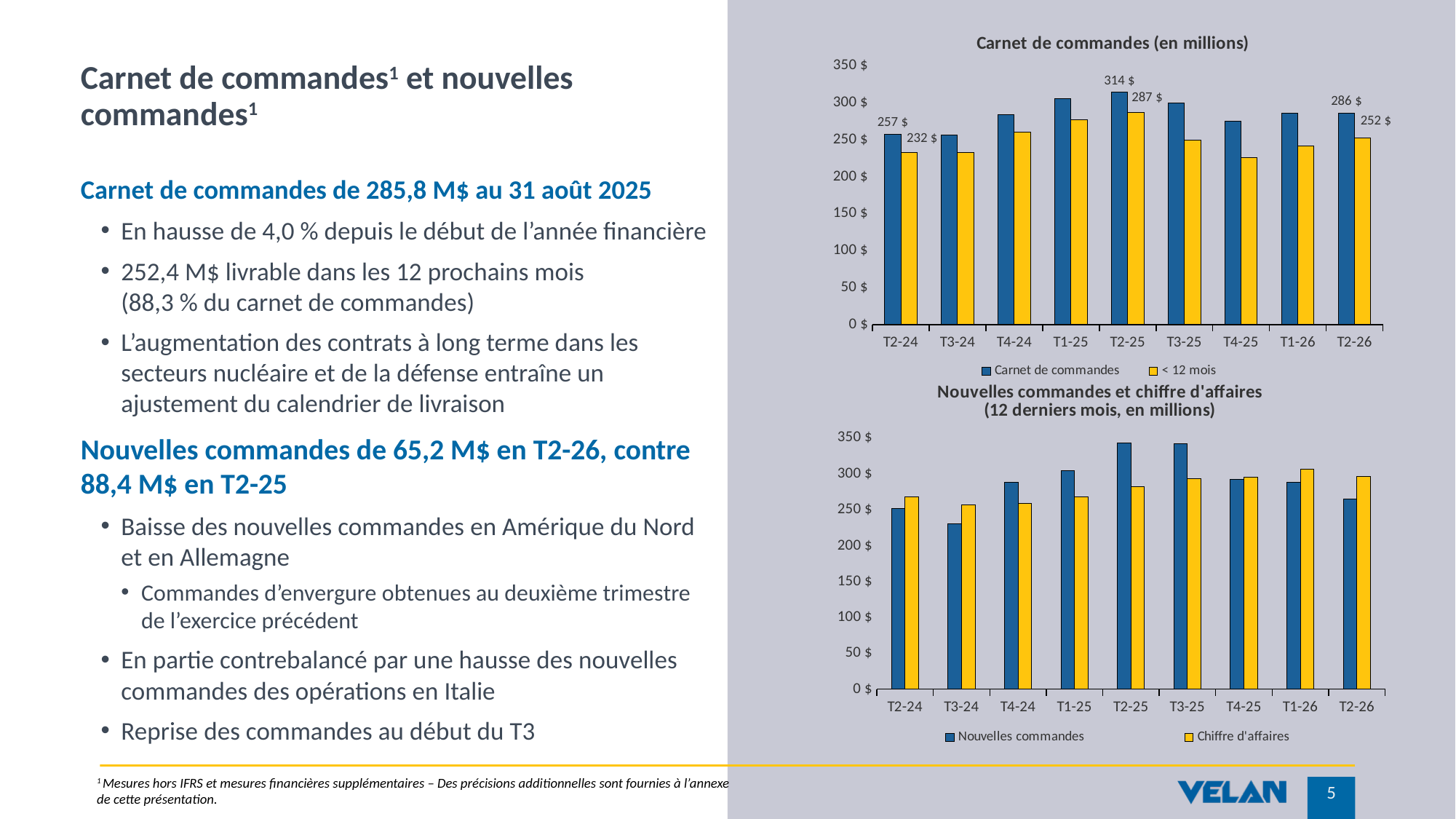
In the chart titled "Carnet de commandes (en millions)", what is the difference between the Carnet de commandes value and the "< 12 mois" value for T2-25? 27 $ In the chart titled "Carnet de commandes (en millions)", by how much did the Carnet de commandes value change from T2-24 to T2-26? 29 $ In the chart titled "Nouvelles commandes et chiffre d'affaires", is the Nouvelles commandes value for T2-25 greater or less than 300 $? greater In the chart titled "Nouvelles commandes et chiffre d'affaires", which is larger for T2-26: Nouvelles commandes or Chiffre d'affaires? Chiffre d'affaires In the chart titled "Carnet de commandes (en millions)", what is the value of the "< 12 mois" series for T2-26? 252 $ How many series does the legend list in the chart titled "Nouvelles commandes et chiffre d'affaires"? 2 What kind of chart is the chart titled "Nouvelles commandes et chiffre d'affaires"? Bar chart In the chart titled "Carnet de commandes (en millions)", what is the value of the Carnet de commandes series for T2-25? 314 $ In the chart titled "Nouvelles commandes et chiffre d'affaires", is the Nouvelles commandes value for T3-24 greater or less than 250 $? less What are the two legend entries in the chart titled "Carnet de commandes (en millions)"? Carnet de commandes and < 12 mois In the chart titled "Carnet de commandes (en millions)", which quarter has the highest Carnet de commandes value? T2-25 How many quarters are shown on the x axis of the chart titled "Carnet de commandes (en millions)"? 9